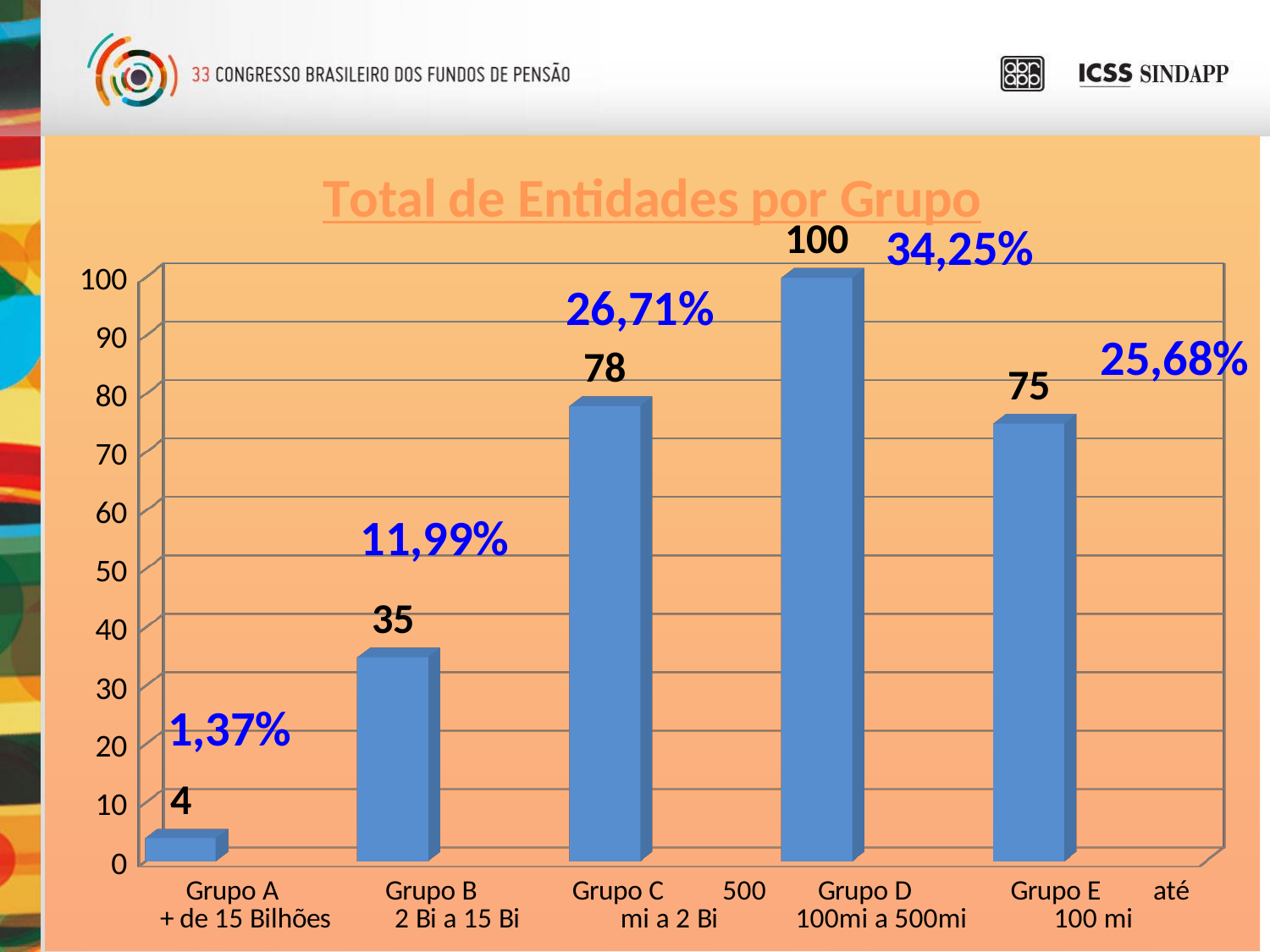
What is the value for Grupo E? 75 Which is larger, the value for Grupo B or the value for Grupo E? Grupo E What is the difference between the values for Grupo D and Grupo B? 65 What percentage is shown next to Grupo D? 34,25% What is the value for Grupo C? 78 How many groups are shown on the x axis? 5 Which group has the lowest number of entities? Grupo A What is the value for Grupo A in the chart 'Total de Entidades por Grupo'? 4 What is the title of the chart? Total de Entidades por Grupo What is the difference between the values for Grupo C and Grupo E? 3 What kind of chart is shown on the slide? Bar chart Which group has the highest number of entities? Grupo D